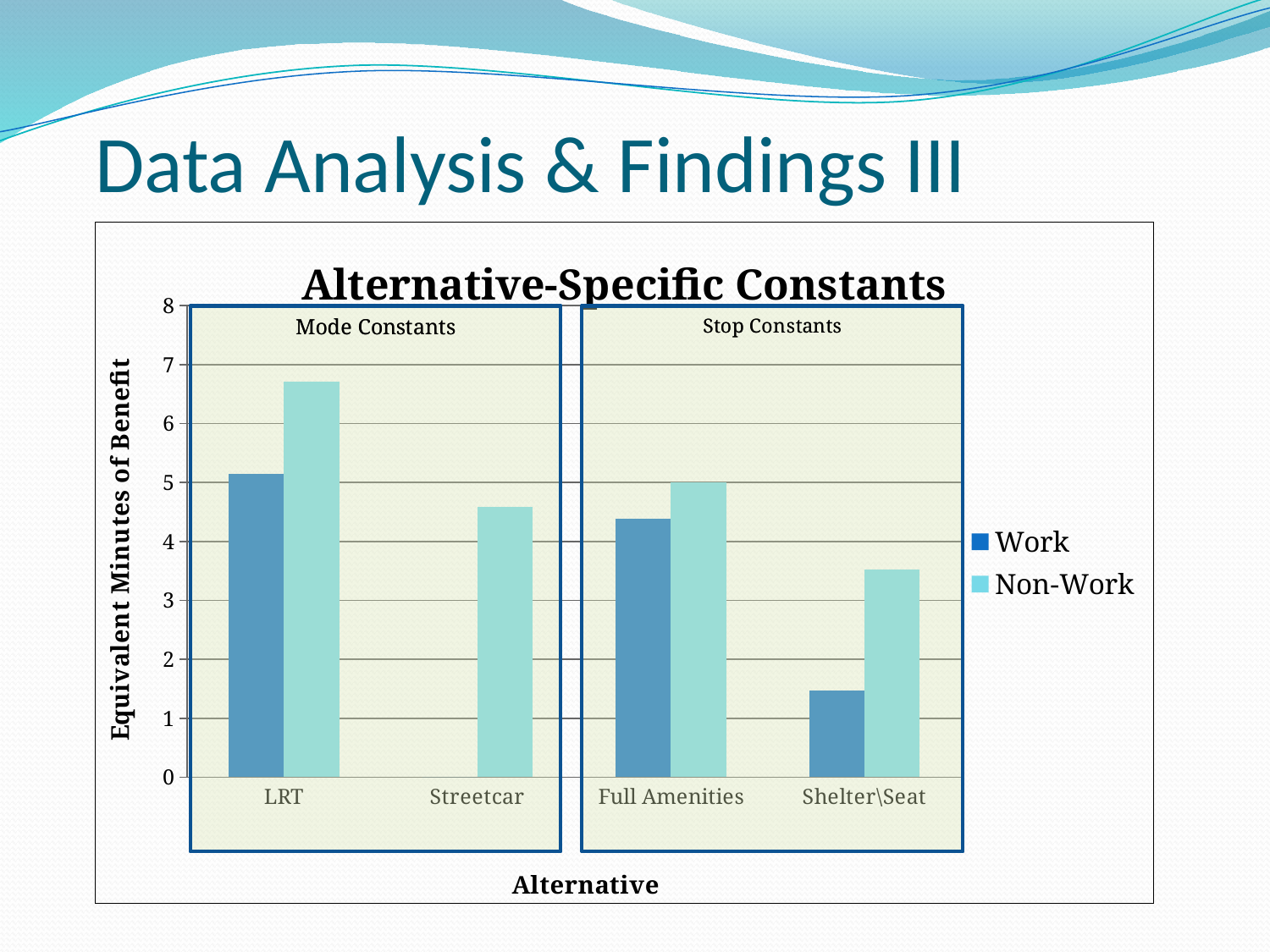
Which category has the highest Work value in the "Alternative-Specific Constants" chart? LRT For LRT, which series has the larger value, Work or Non-Work? Non-Work Which category has the lowest Non-Work value in the "Alternative-Specific Constants" chart? Shelter\Seat What kind of chart is shown under the title "Alternative-Specific Constants"? bar chart Among the categories with a visible Work bar, which has the lowest Work value? Shelter\Seat Is the Non-Work value for Streetcar greater or less than 4? greater Is the Non-Work value for LRT greater or less than 6? greater What is the title of the y axis in the "Alternative-Specific Constants" chart? Equivalent Minutes of Benefit Is the Work value for Shelter\Seat greater or less than 2? less How many series does the legend of the "Alternative-Specific Constants" chart list? 2 Which category has the highest Non-Work value in the "Alternative-Specific Constants" chart? LRT How many categories are shown on the x axis of the "Alternative-Specific Constants" chart? 4